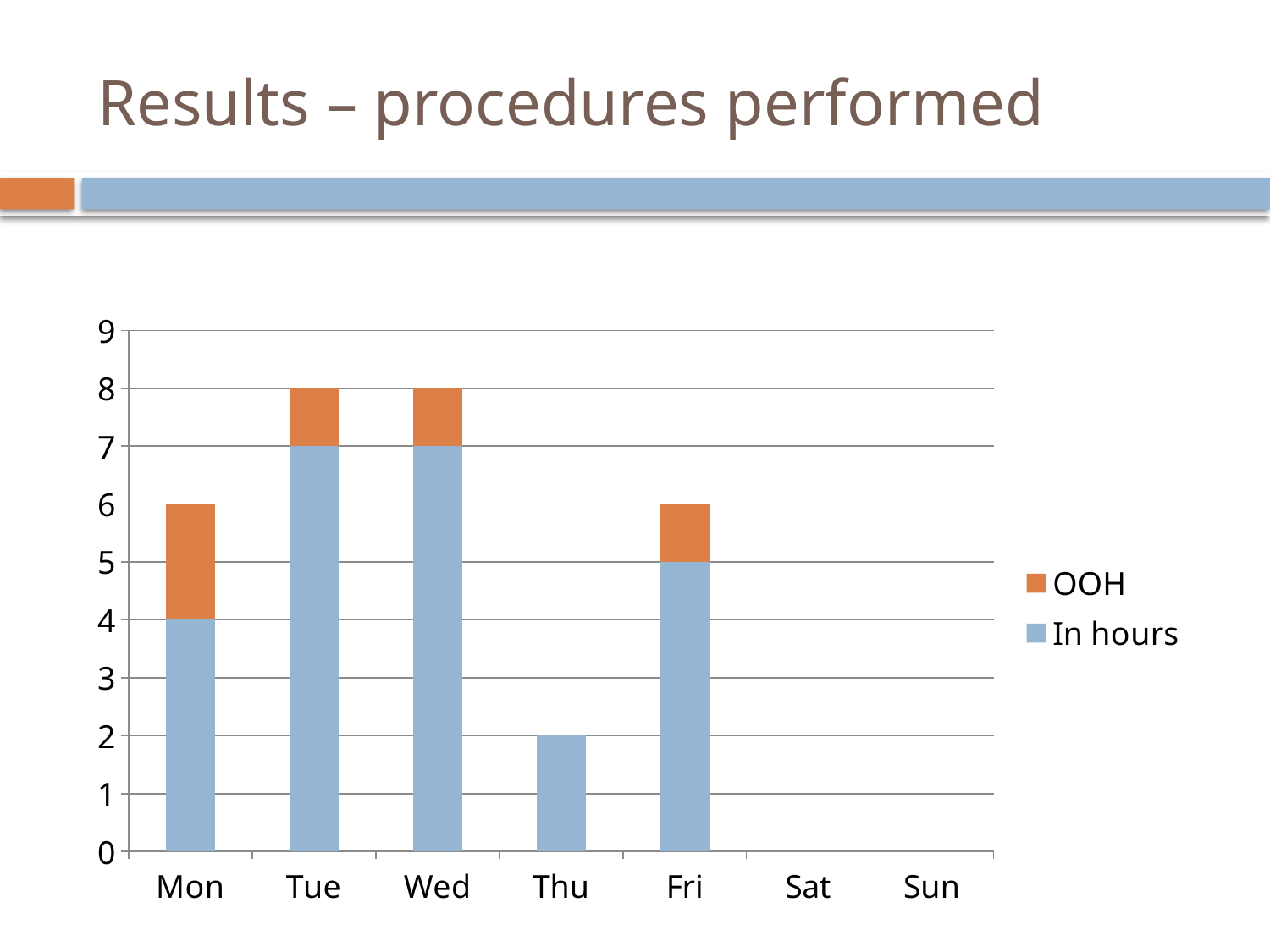
What is the difference between the In hours values for Tue and Mon? 3 What is the total height of the stacked bar for Tue? 8 What kind of chart is shown on the slide? Stacked bar chart Which is larger, the In hours value for Fri or for Mon? Fri Is the total value for Thu greater or less than 3? less What is the total height of the stacked bar for Mon? 6 What is the In hours value for Mon? 4 Which series is shown in orange in the legend? OOH What is the In hours value for Fri? 5 What is the In hours value for Thu? 2 How many series does the legend list? 2 How many day categories are shown on the x axis? 7